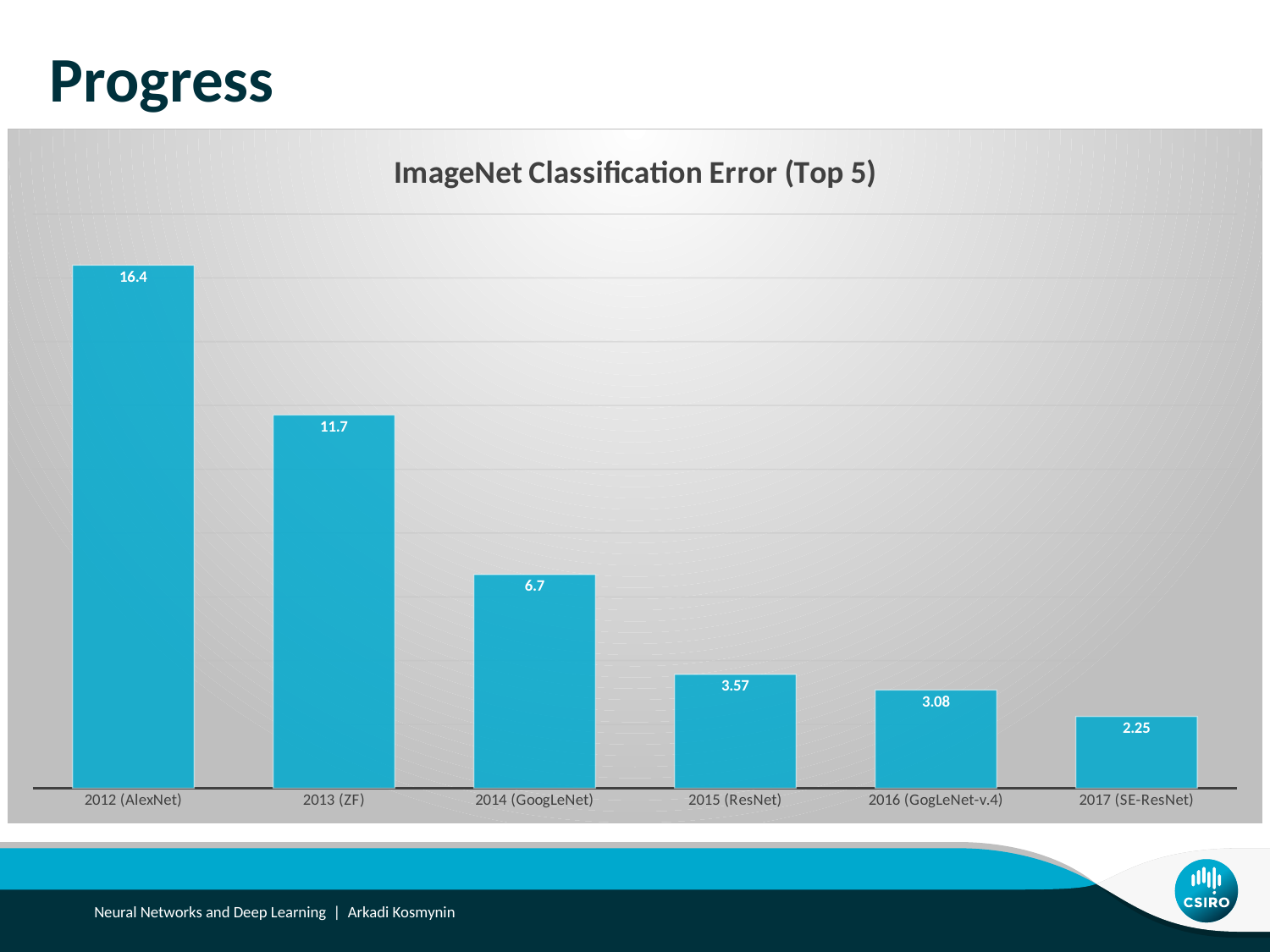
Do the values rise or fall from left to right along the x axis? Fall Which category has the highest classification error? 2012 (AlexNet) What is the value shown for 2015 (ResNet)? 3.57 What kind of chart is shown on the slide? Bar chart What is the difference between the values for 2014 (GoogLeNet) and 2015 (ResNet)? 3.13 Which is larger, the value for 2016 (GogLeNet-v.4) or 2017 (SE-ResNet)? 2016 (GogLeNet-v.4) Which category has the lowest classification error? 2017 (SE-ResNet) What is the value shown for 2017 (SE-ResNet)? 2.25 What is the title of the chart? ImageNet Classification Error (Top 5) What is the difference between the values for 2012 (AlexNet) and 2013 (ZF)? 4.7 What is the ImageNet classification error for 2012 (AlexNet)? 16.4 How many categories are shown on the x axis? 6